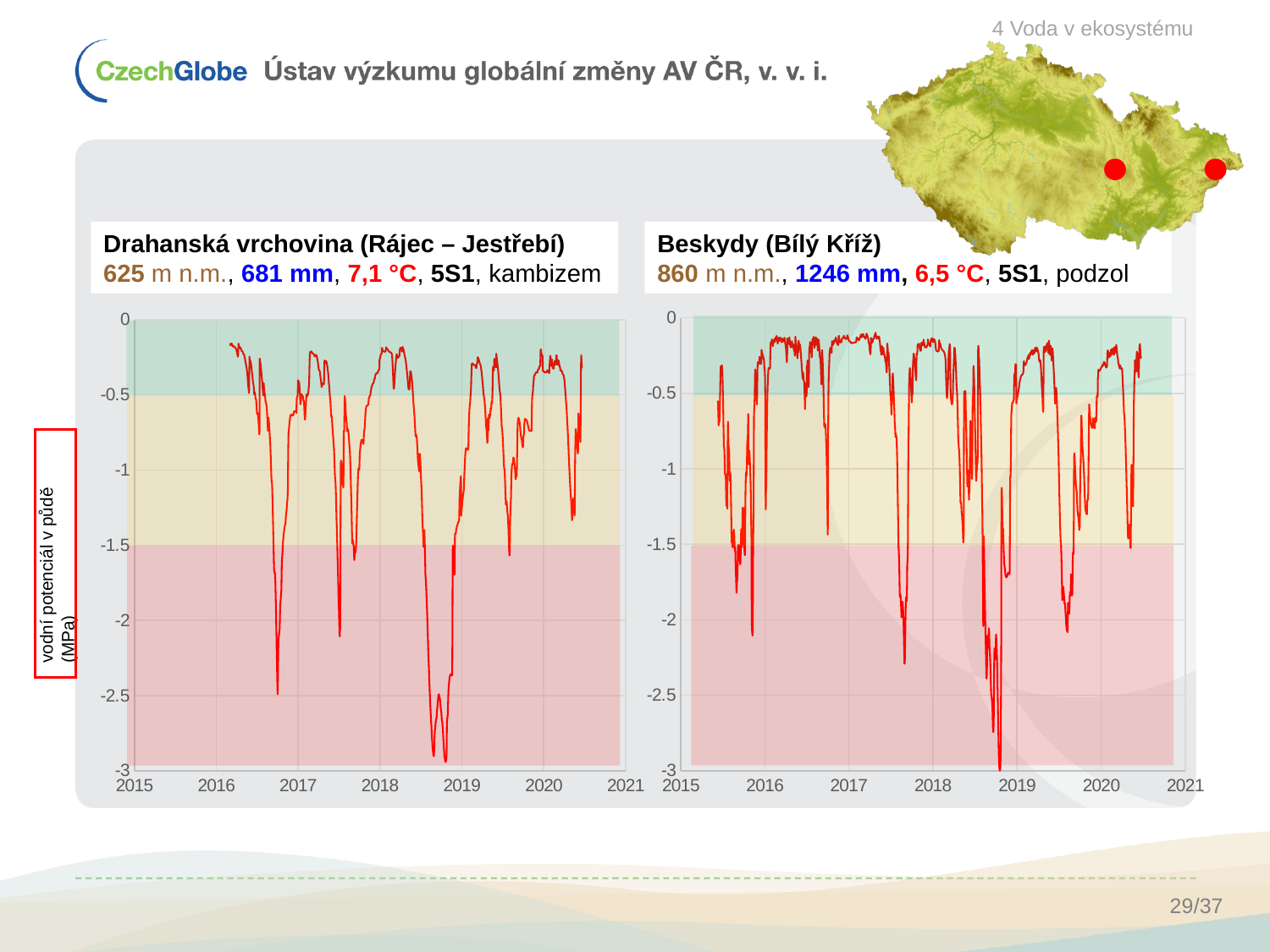
What kind of chart is shown on the left, titled Drahanská vrchovina (Rájec – Jestřebí)? line chart What is the lowest value shown on the y axis of the right chart (Beskydy)? -3 In the right chart (Beskydy), is the value at the start of 2017 greater or less than -0.5? greater What is the first year shown on the x axis of the left chart (Drahanská vrchovina)? 2015 What kind of chart is shown on the right, titled Beskydy (Bílý Kříž)? line chart What quantity is plotted on the y axis of the two charts? vodní potenciál v půdě (MPa) In the left chart (Drahanská vrchovina), is the lowest value reached in late 2016 greater or less than -2? less In the right chart (Beskydy), is the lowest value reached in late 2019 greater or less than -1.5? less